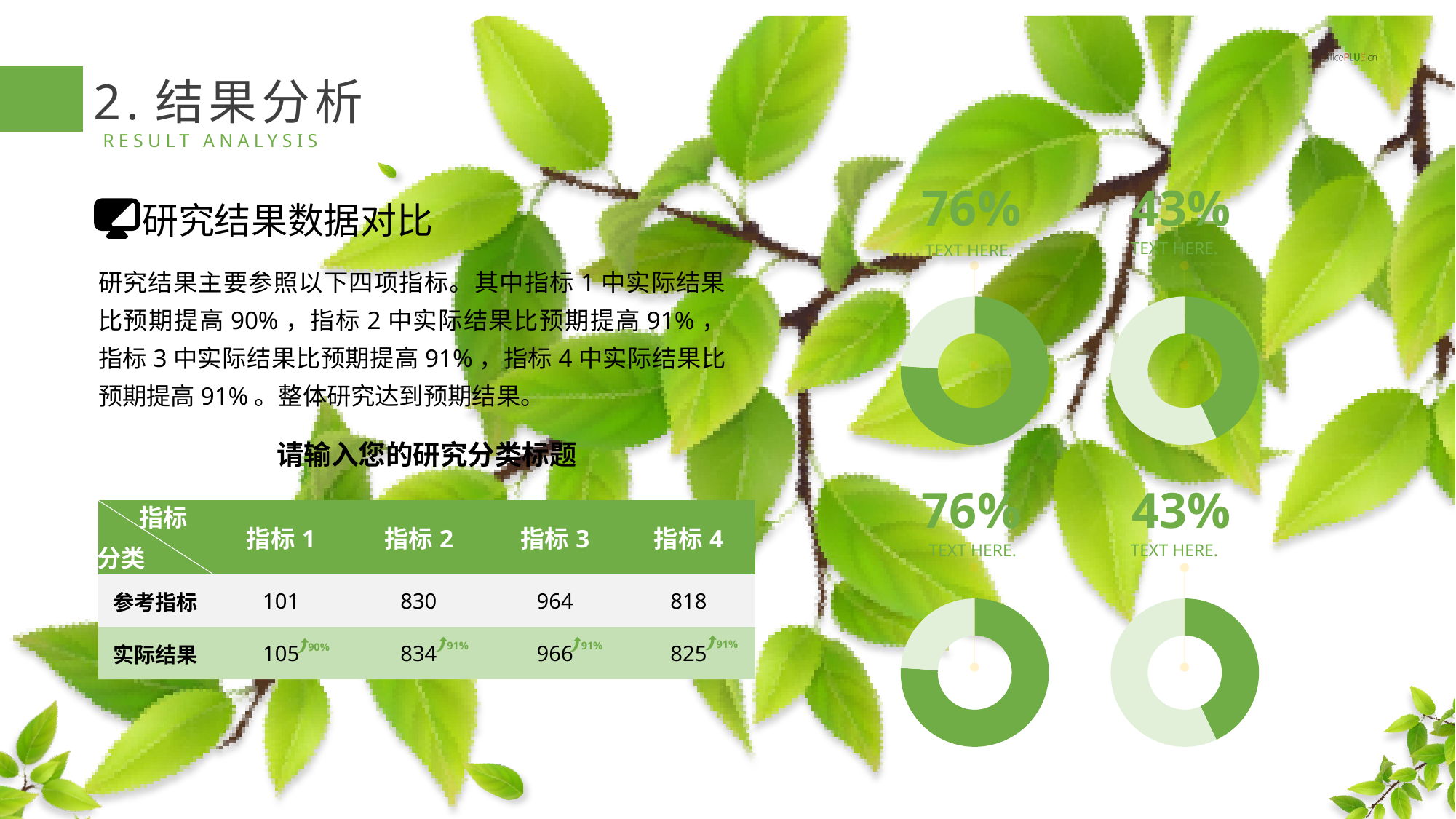
How many of the donut charts show a value of 43%? 2 Which is larger, the percentage for the top-left donut chart or the top-right donut chart? Top-left (76%) How many donut charts are on the slide? 4 What percentage is printed above the bottom-left donut chart? 76% What percentage is printed above the top-left donut chart? 76% What kind of chart is shown four times on the right side of the slide? Donut (pie) chart Which of the four donut charts shows the lowest percentage? The two 43% charts (top-right and bottom-right) What placeholder text appears under each percentage above the donut charts? TEXT HERE. What share of the bottom-right donut chart does the dark green slice represent? 43% What is the difference between the percentage of the top-left donut chart and the top-right donut chart? 33% What percentage is printed above the bottom-right donut chart? 43% What percentage is printed above the top-right donut chart? 43%